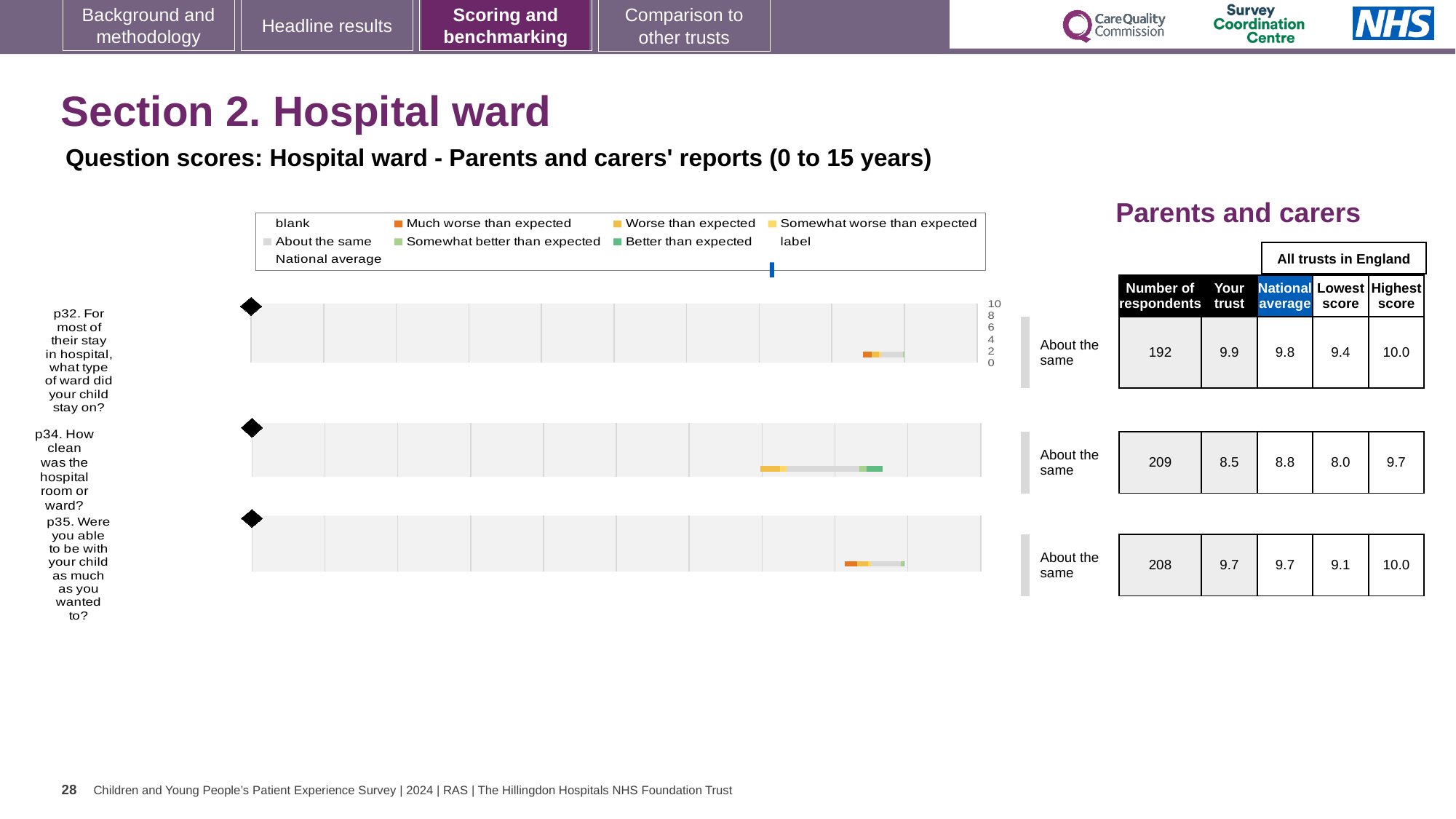
For p35 (were you able to be with your child as much as you wanted to), what is the national average score? 9.7 For p34 (how clean was the hospital room or ward), what is the 'Your trust' score? 8.5 For p32 (what type of ward did your child stay on), how many respondents are listed? 192 Which question has the highest 'Your trust' score? p32 How many questions (charts) are shown on the slide? 3 What kind of chart is used to show the question scores on this slide? bar chart What benchmark category is shown for p32? About the same For p35, what is the lowest score among all trusts in England? 9.1 Which question has the lowest 'Your trust' score? p34 For p34, what is the difference between the highest score and the lowest score among all trusts in England? 1.7 What colour does the legend use for 'Much worse than expected'? Orange For p34, which is larger: the 'Your trust' score or the national average? National average